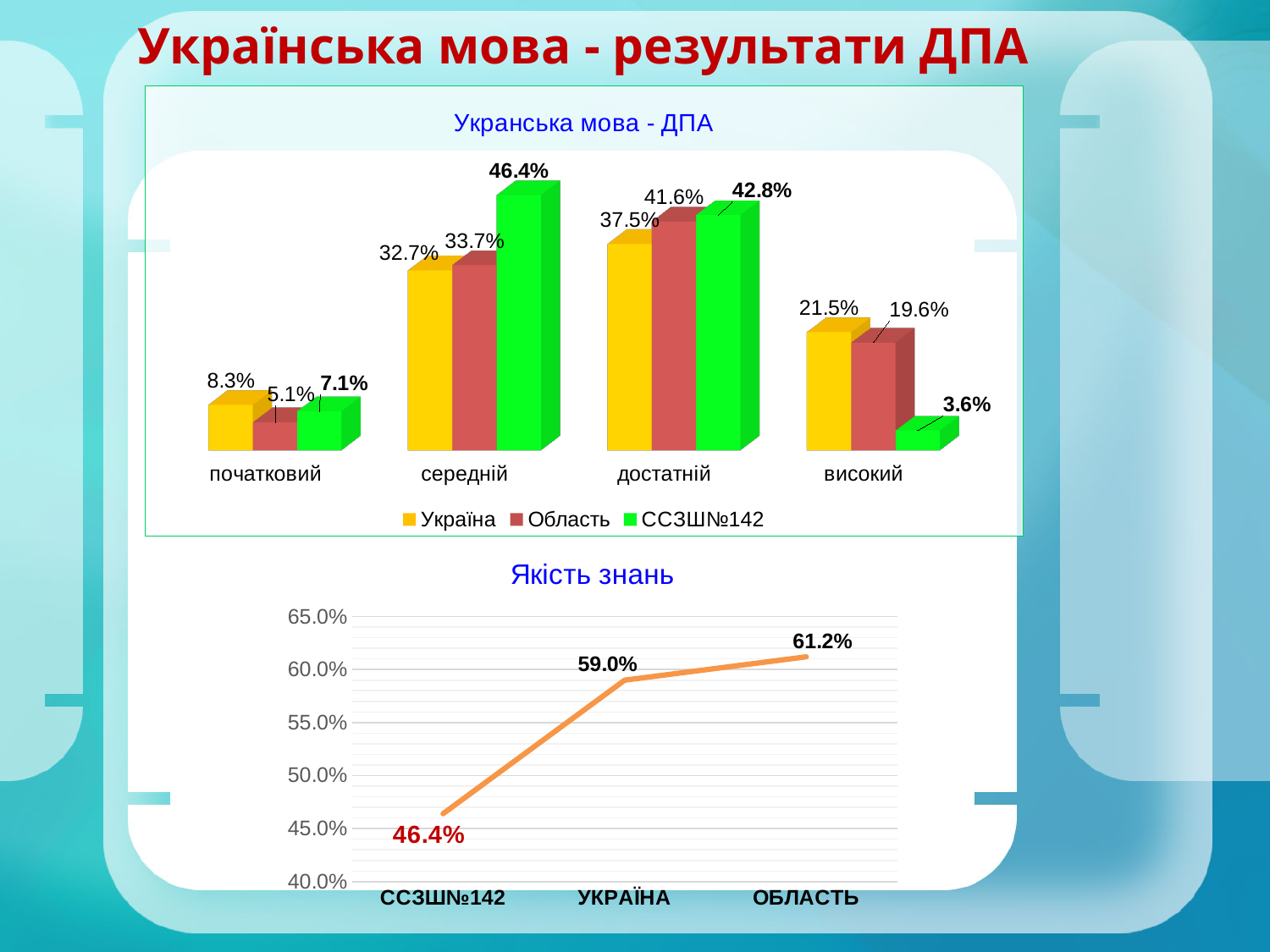
In the bottom chart 'Якість знань', what is the value for УКРАЇНА? 59.0% In the top chart 'Укранська мова - ДПА', what is the value for ССЗШ№142 in the 'середній' category? 46.4% In the bottom chart 'Якість знань', what is the difference between the values for ОБЛАСТЬ and ССЗШ№142? 14.8% In the top chart 'Укранська мова - ДПА', how many categories are shown on the x axis? 4 In the top chart 'Укранська мова - ДПА', what is the value for Область in the 'високий' category? 19.6% In the top chart 'Укранська мова - ДПА', how many series does the legend list? 3 In the top chart 'Укранська мова - ДПА', what is the value for Україна in the 'достатній' category? 37.5% In the top chart 'Укранська мова - ДПА', what is the difference between the Україна and ССЗШ№142 values in the 'високий' category? 17.9% In the top chart 'Укранська мова - ДПА', which category has the lowest value for ССЗШ№142? високий In the bottom chart 'Якість знань', do the values rise or fall from left to right along the x axis? rise What kind of chart is the bottom chart 'Якість знань'? line chart In the top chart 'Укранська мова - ДПА', which is larger in the 'початковий' category: Україна or Область? Україна